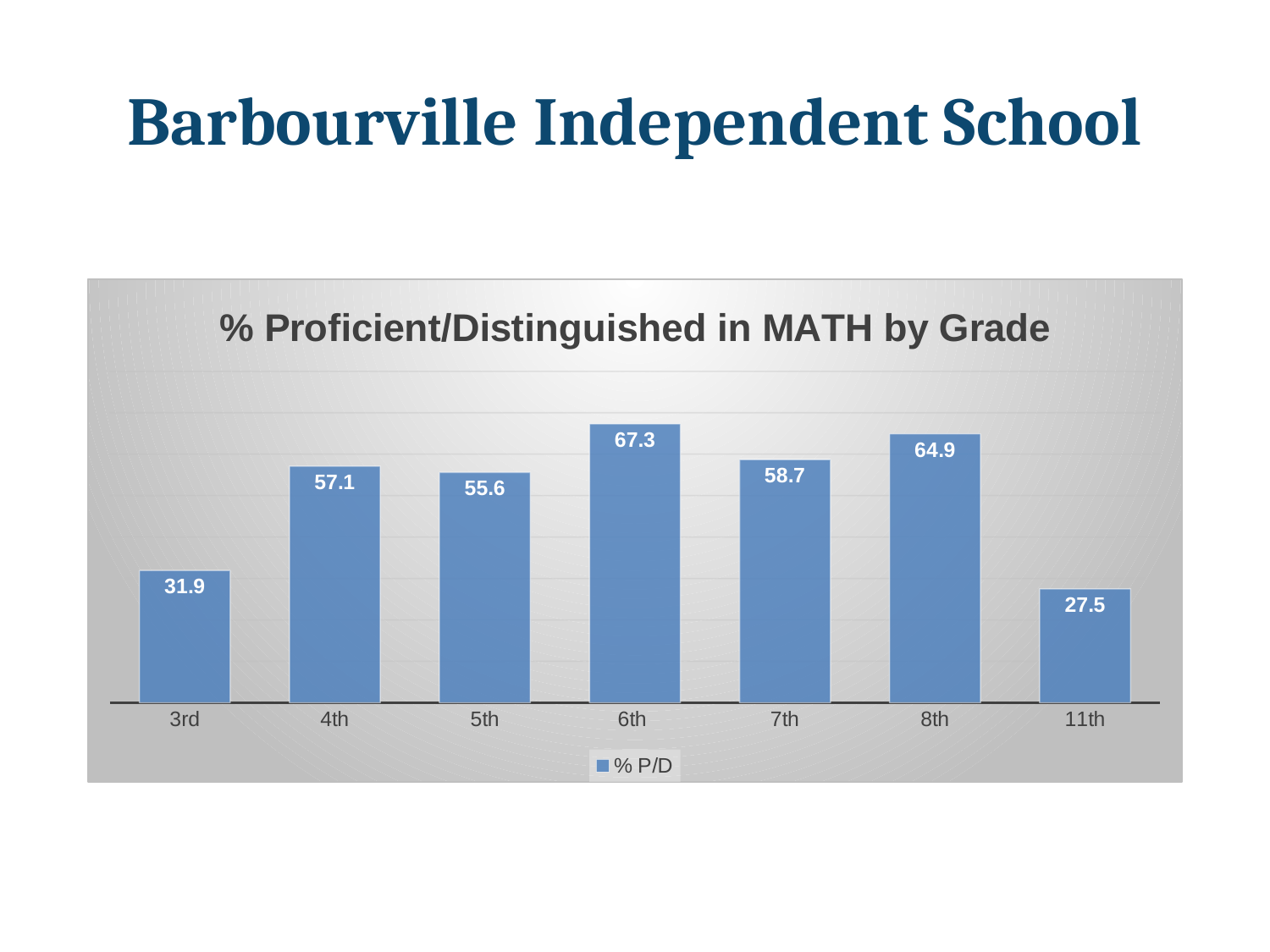
What is the % P/D value for 3rd grade? 31.9 What is the % P/D value for 6th grade? 67.3 Which grade has the highest % Proficient/Distinguished in MATH? 6th What is the difference between the % P/D values for 8th grade and 7th grade? 6.2 Which grade has a higher % P/D value, 3rd or 11th? 3rd What is the difference between the % P/D values for 6th grade and 11th grade? 39.8 How many grades are shown on the x axis of the chart? 7 Which grade has a higher % P/D value, 4th or 5th? 4th What is the title of the chart? % Proficient/Distinguished in MATH by Grade Which grade has the lowest % Proficient/Distinguished in MATH? 11th What is the % P/D value for 11th grade? 27.5 What type of chart is shown on the slide? Bar chart